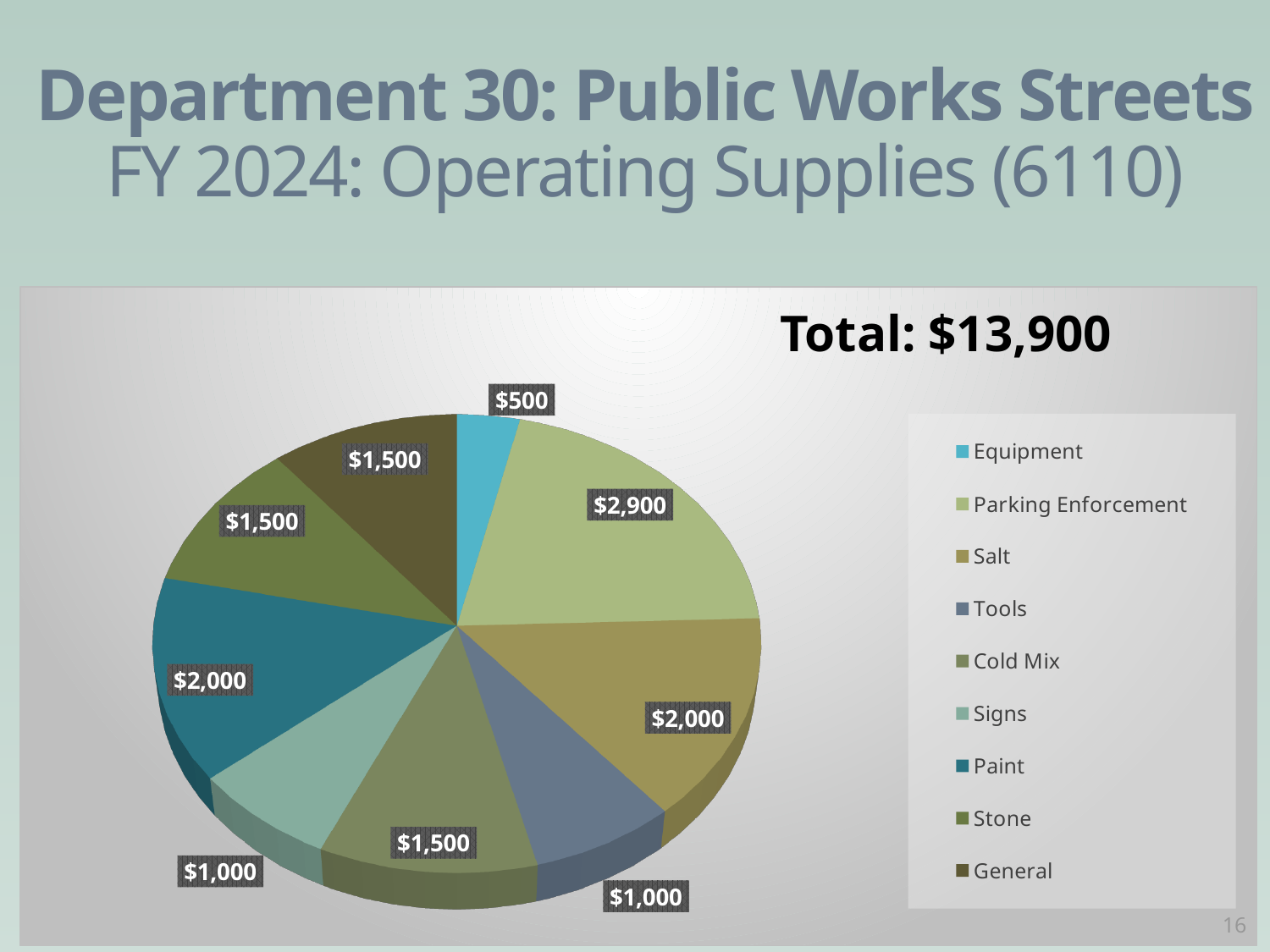
What is the value for Parking Enforcement? $2,900 What is the difference between the Parking Enforcement value and the Equipment value? $2,400 Which is larger, the value for Paint or the value for Tools? Paint What is the value for Cold Mix? $1,500 How many categories does the pie chart have? 9 What total is shown on the slide for the pie chart? $13,900 What is the subtitle of the slide below 'Department 30: Public Works Streets'? FY 2024: Operating Supplies (6110) What is the value for Equipment? $500 What is the value for Salt? $2,000 Which category has the largest slice of the pie? Parking Enforcement What type of chart is shown on the slide? Pie chart Which category has the smallest slice of the pie? Equipment